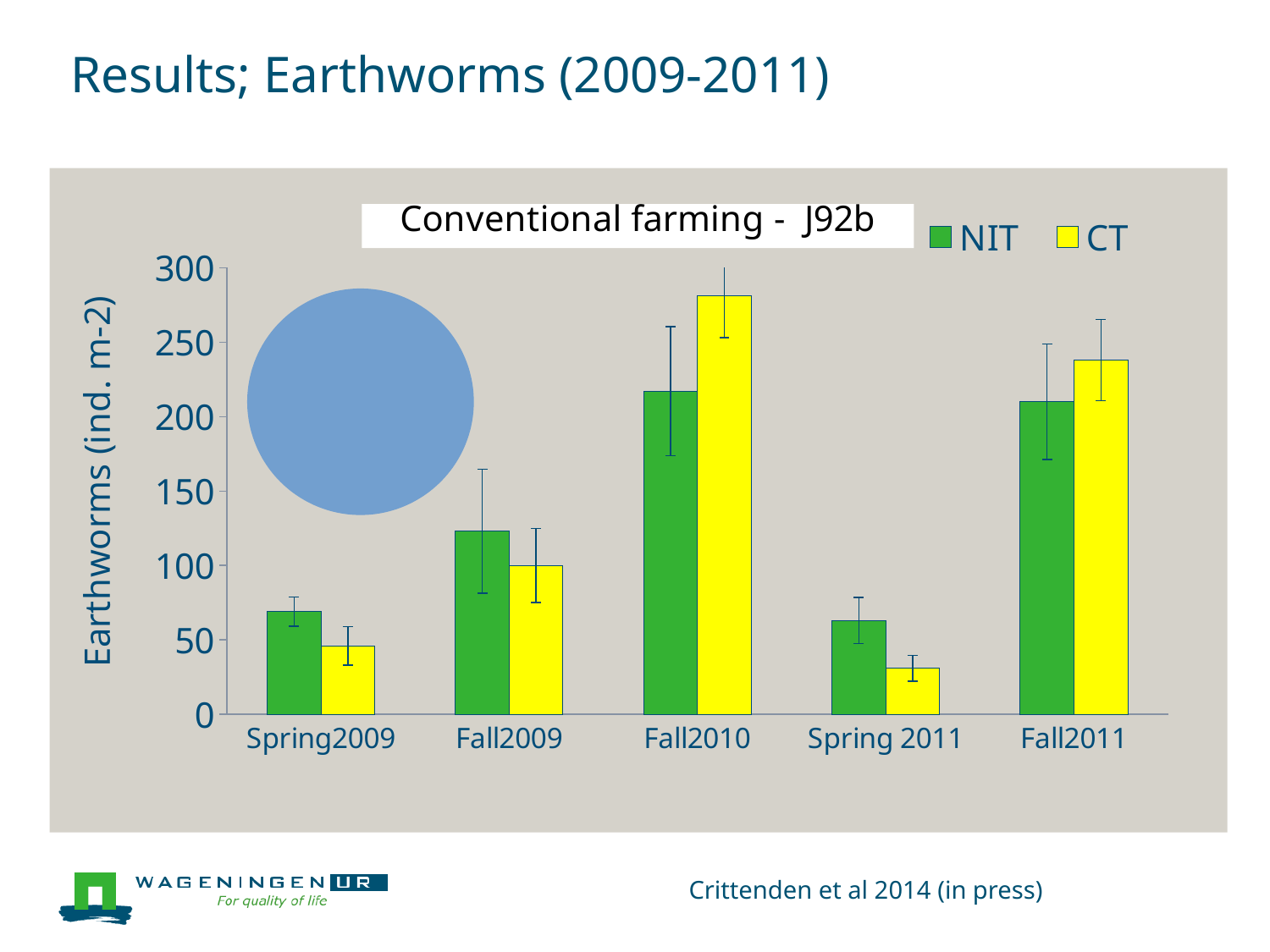
How many categories are shown on the x axis? 5 Is the CT value for Fall2010 greater or less than 250? greater Which category has the lowest CT value? Spring 2011 Is the NIT value for Fall2011 greater or less than 150? greater What kind of chart is shown on the slide? Bar chart Is the CT value for Spring 2011 greater or less than 50? less What is the title shown inside the chart? Conventional farming - J92b In Spring 2011, which series has the larger value, NIT or CT? NIT Which category has the highest NIT value? Fall2010 How many series does the legend list? 2 Which category has the highest CT value? Fall2010 In Fall2010, which series has the larger value, NIT or CT? CT